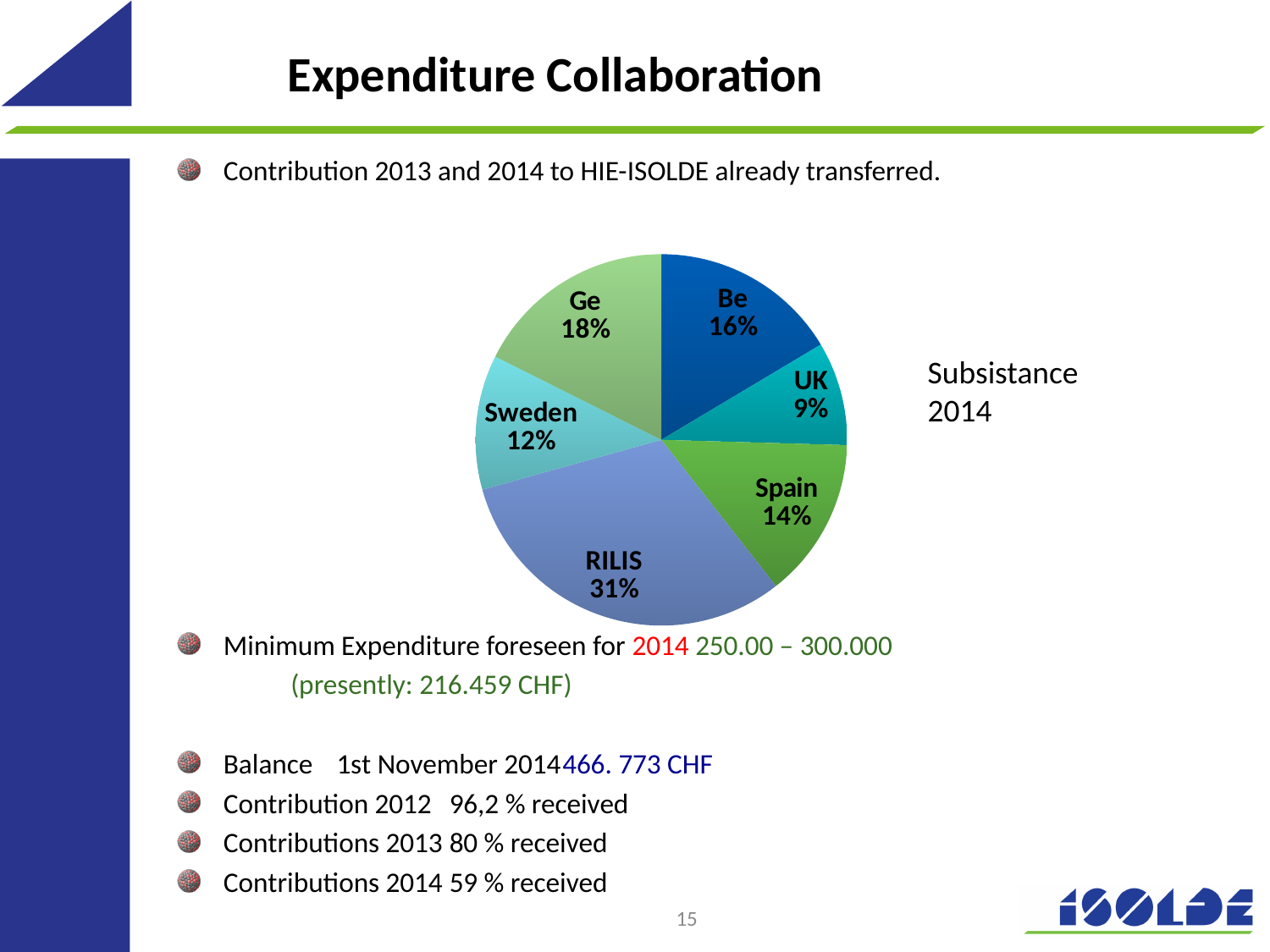
Which slice of the pie is the largest? RILIS Which is larger, the share for Be or the share for Spain? Be What is the difference between the shares of Ge and Spain? 4% What is the value shown for Sweden? 12% What kind of chart is shown on the slide? Pie chart What is the value shown for Be? 16% Which slice of the pie is the smallest? UK What is the value shown for Spain? 14% What label appears to the right of the pie chart? Subsistance 2014 How many slices does the pie chart have? 6 What is the combined share of Be and UK? 25% What share of the pie does RILIS account for? 31%